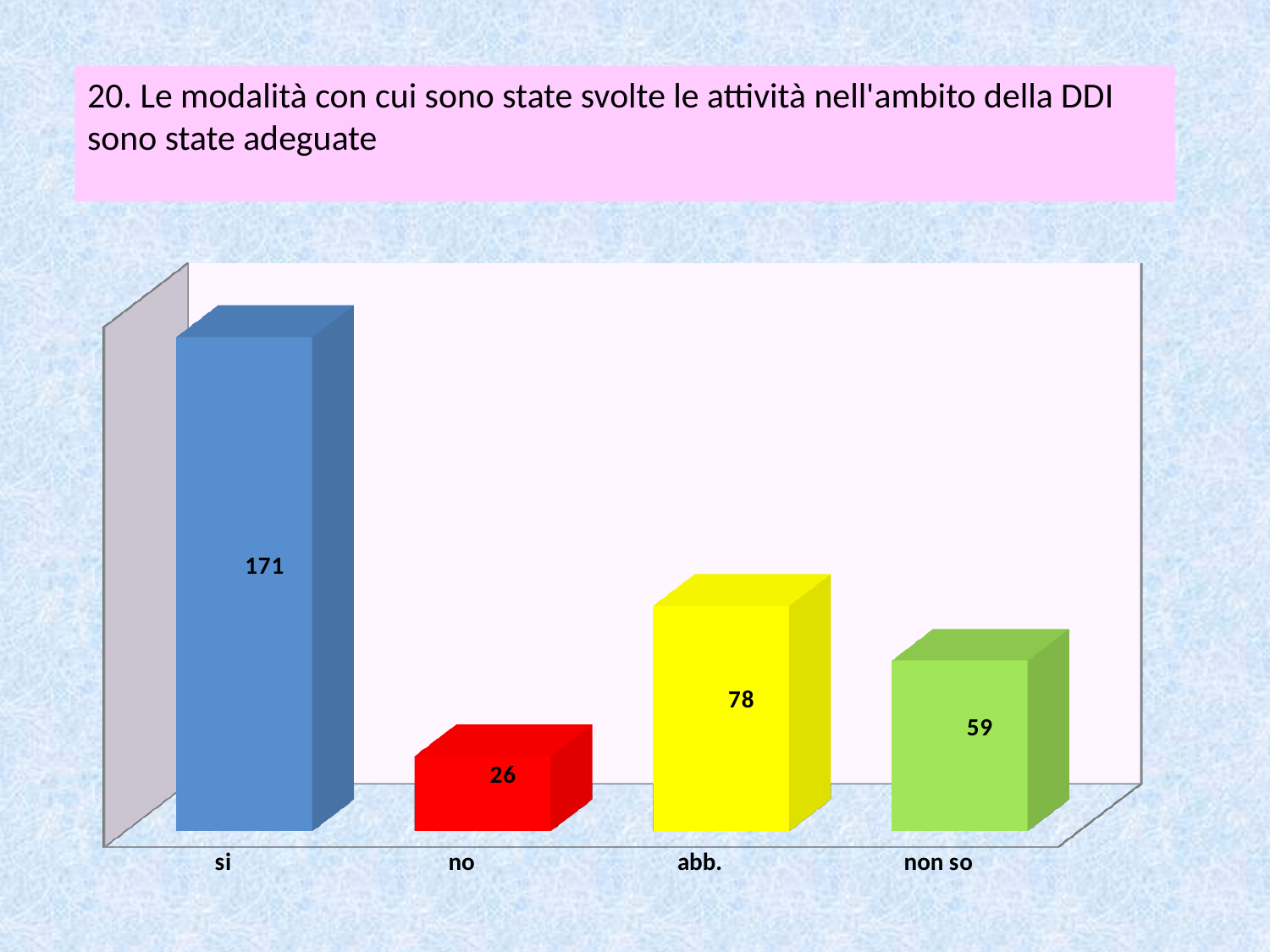
What colour is the bar for "no"? red Which category has the lowest value? no What kind of chart is shown on the slide? bar chart What is the difference between the values for "abb." and "non so"? 19 What is the value for "no"? 26 What is the value for "non so"? 59 What is the value for "si"? 171 Which is larger, the value for "abb." or the value for "non so"? abb. What is the difference between the values for "si" and "abb."? 93 How many categories are shown on the x axis? 4 Which category has the highest value? si What is the value for "abb."? 78